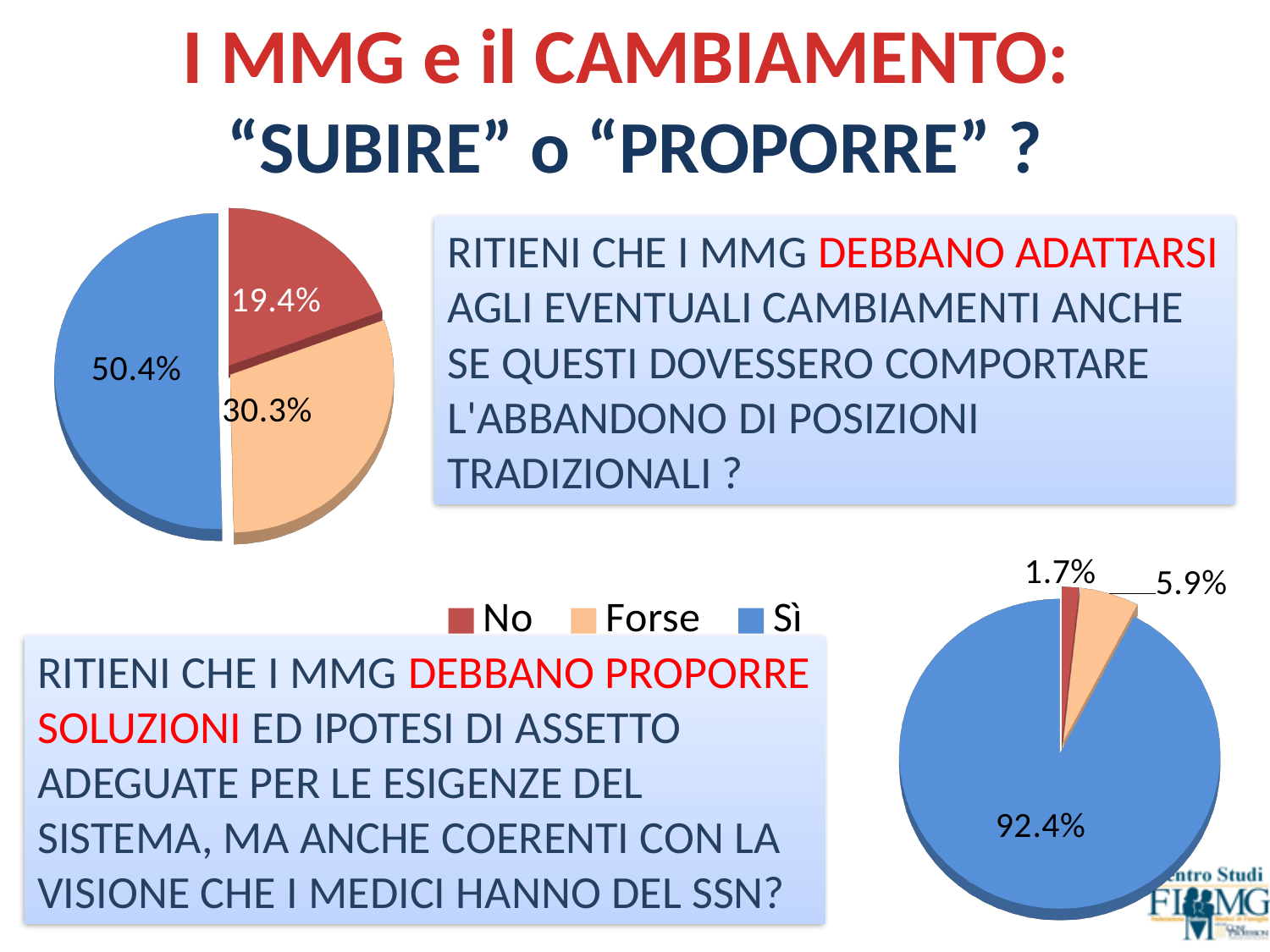
In the bottom-right pie chart, what percentage is shown for the "No" slice? 1.7% In the bottom-right pie chart, which category has the smallest slice? No In the bottom-right pie chart, which is larger, the "Forse" slice or the "No" slice? Forse In the top-left pie chart, what percentage is shown for the "Sì" slice? 50.4% What colour represents the "Sì" category in the pie charts? Blue In the top-left pie chart, what is the difference between the "Forse" and "No" percentages? 10.9% In the bottom-right pie chart, what percentage is shown for the "Sì" slice? 92.4% In the top-left pie chart, what percentage is shown for the "Forse" slice? 30.3% In the top-left pie chart, which category has the largest slice? Sì What kind of chart is used in the top-left of the slide? Pie chart How many categories does the legend list for the pie charts? 3 In the top-left pie chart, what percentage is shown for the "No" slice? 19.4%